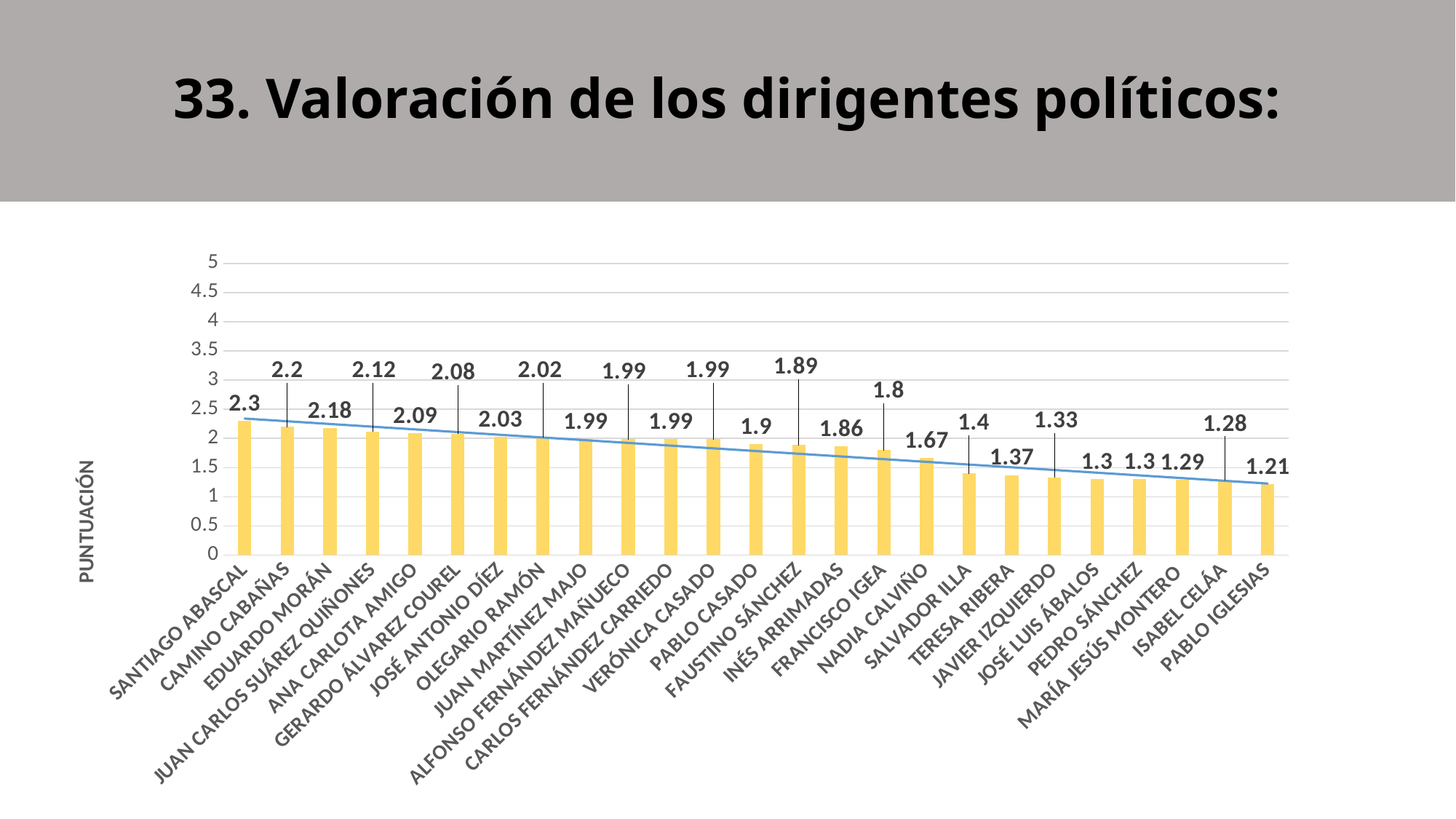
What is the difference between the values for Francisco Igea and Salvador Illa? 0.4 What kind of chart is shown on the slide? bar chart What is the difference between the values for Santiago Abascal and Pablo Iglesias? 1.09 Which political leader has the lowest score? Pablo Iglesias What is the value for Nadia Calviño? 1.67 Is the value for Camino Cabañas greater or less than 2? greater Which is larger, the value for Inés Arrimadas or the value for Teresa Ribera? Inés Arrimadas How many political leaders are shown on the chart? 25 What is the value for Santiago Abascal? 2.3 What is the value for Pedro Sánchez? 1.3 Do the values rise or fall from left to right along the x axis? fall Which political leader has the highest score? Santiago Abascal